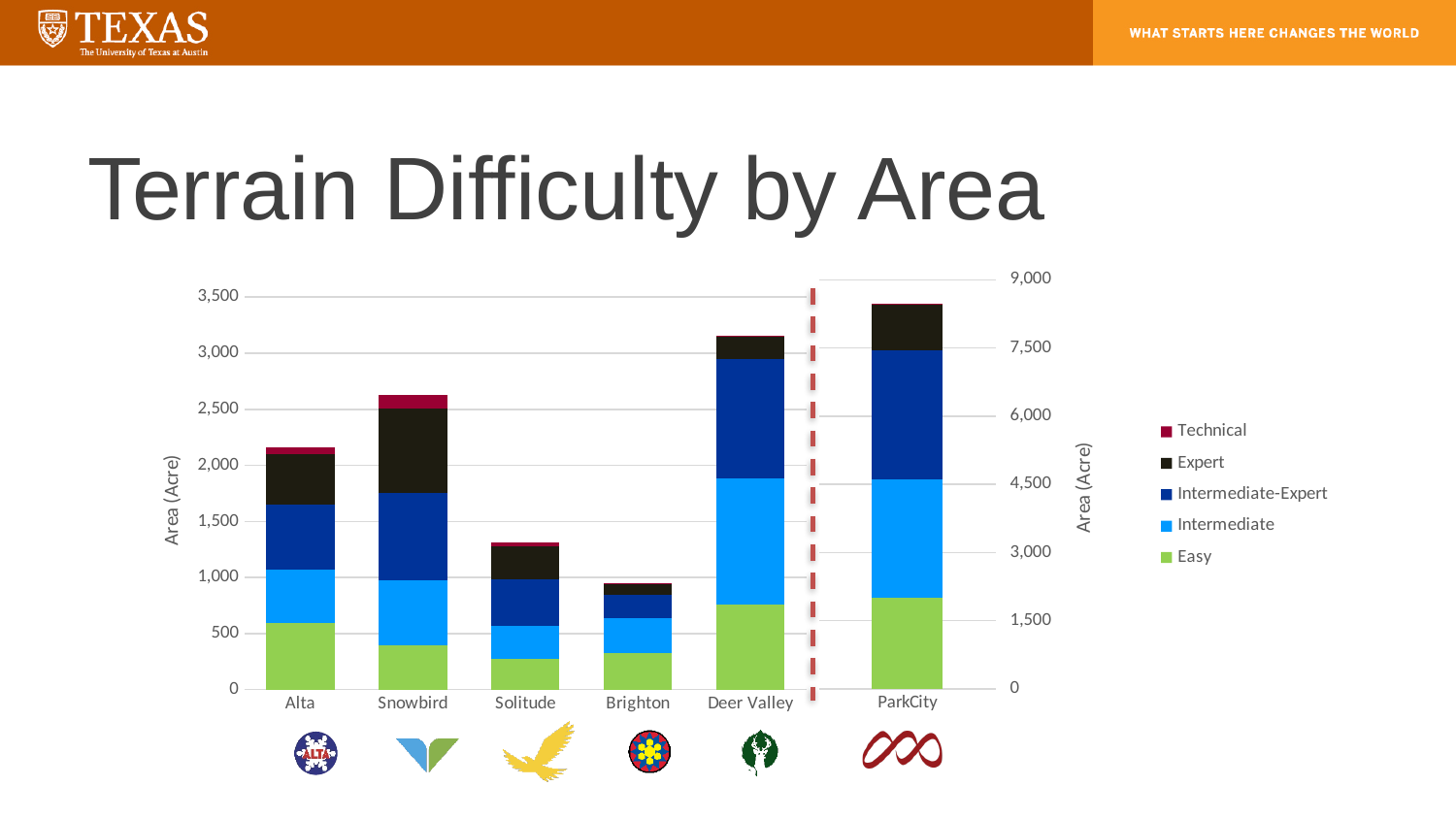
What is the title of the chart on the slide? Terrain Difficulty by Area Which ski area has the shortest stacked bar in the chart? Brighton Is the total bar height for Solitude greater or less than 1,500 on the left axis? less Is the total bar height for Brighton greater or less than 1,000 on the left axis? less Among the five ski areas plotted against the left axis (Alta, Snowbird, Solitude, Brighton, Deer Valley), which has the tallest stacked bar? Deer Valley Is the total bar height for Deer Valley greater or less than 3,000 on the left axis? greater Which legend entry is shown in green in the chart? Easy How many ski areas are shown along the x axis of the chart? 6 Which has the taller stacked bar, Snowbird or Alta? Snowbird How many series does the chart's legend list? 5 What kind of chart is shown on the slide? Stacked bar chart